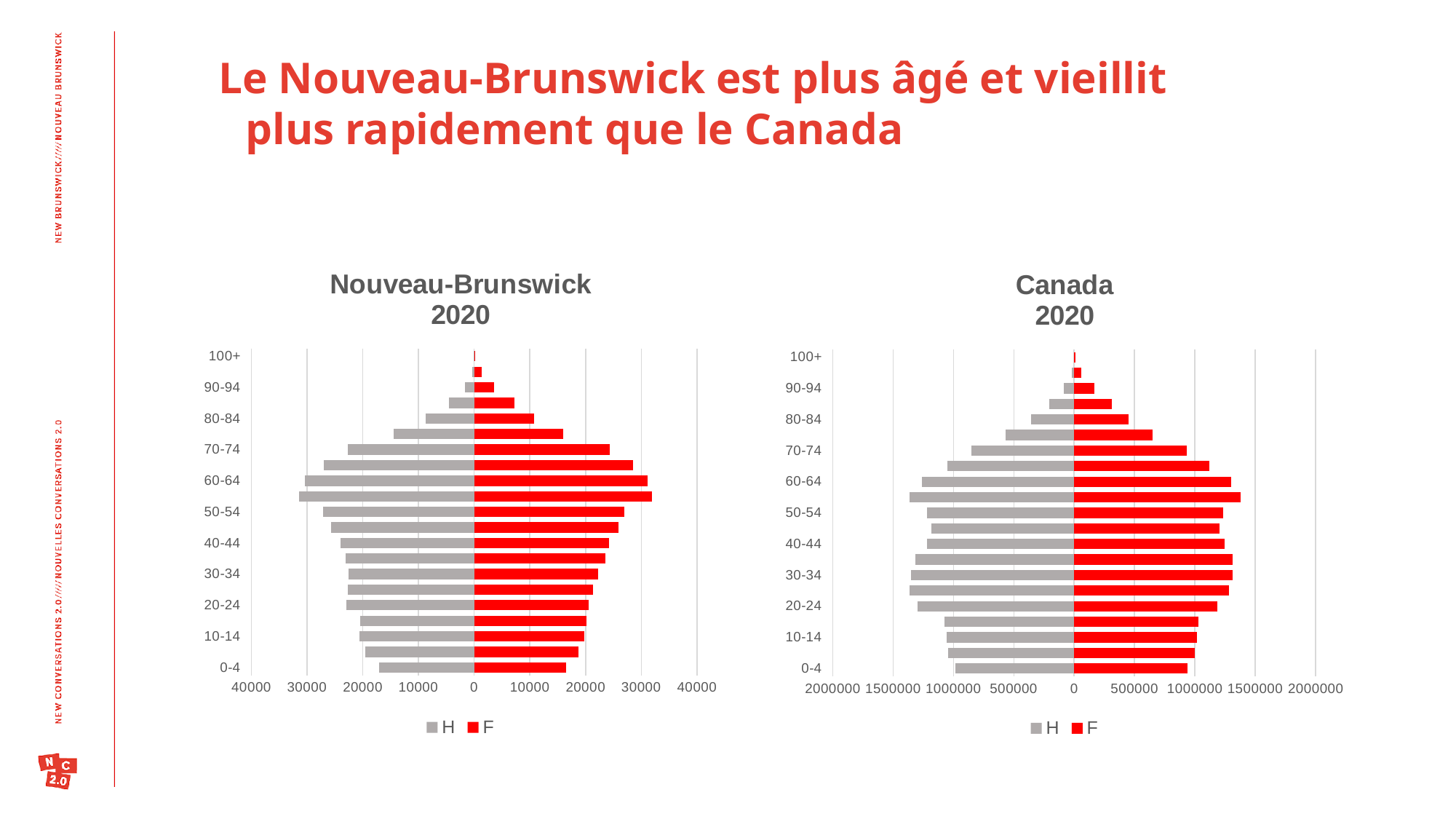
What are the two legend entries in the Nouveau-Brunswick 2020 chart? H and F In the Canada 2020 chart, is the H value for the 70-74 age group greater or less than 1000000? less In the Nouveau-Brunswick 2020 chart, is the F value for the 70-74 age group greater or less than 20000? greater In the Nouveau-Brunswick 2020 chart, which is larger for the F series: the 70-74 age group or the 0-4 age group? 70-74 In the Canada 2020 chart, is the F value for the 30-34 age group greater or less than 1000000? greater What kind of chart is the Nouveau-Brunswick 2020 chart? bar chart In the Canada 2020 chart, which is larger for the H series: the 70-74 age group or the 30-34 age group? 30-34 In the Canada 2020 chart, what colour are the F bars? red How many series does the legend of the Canada 2020 chart list? 2